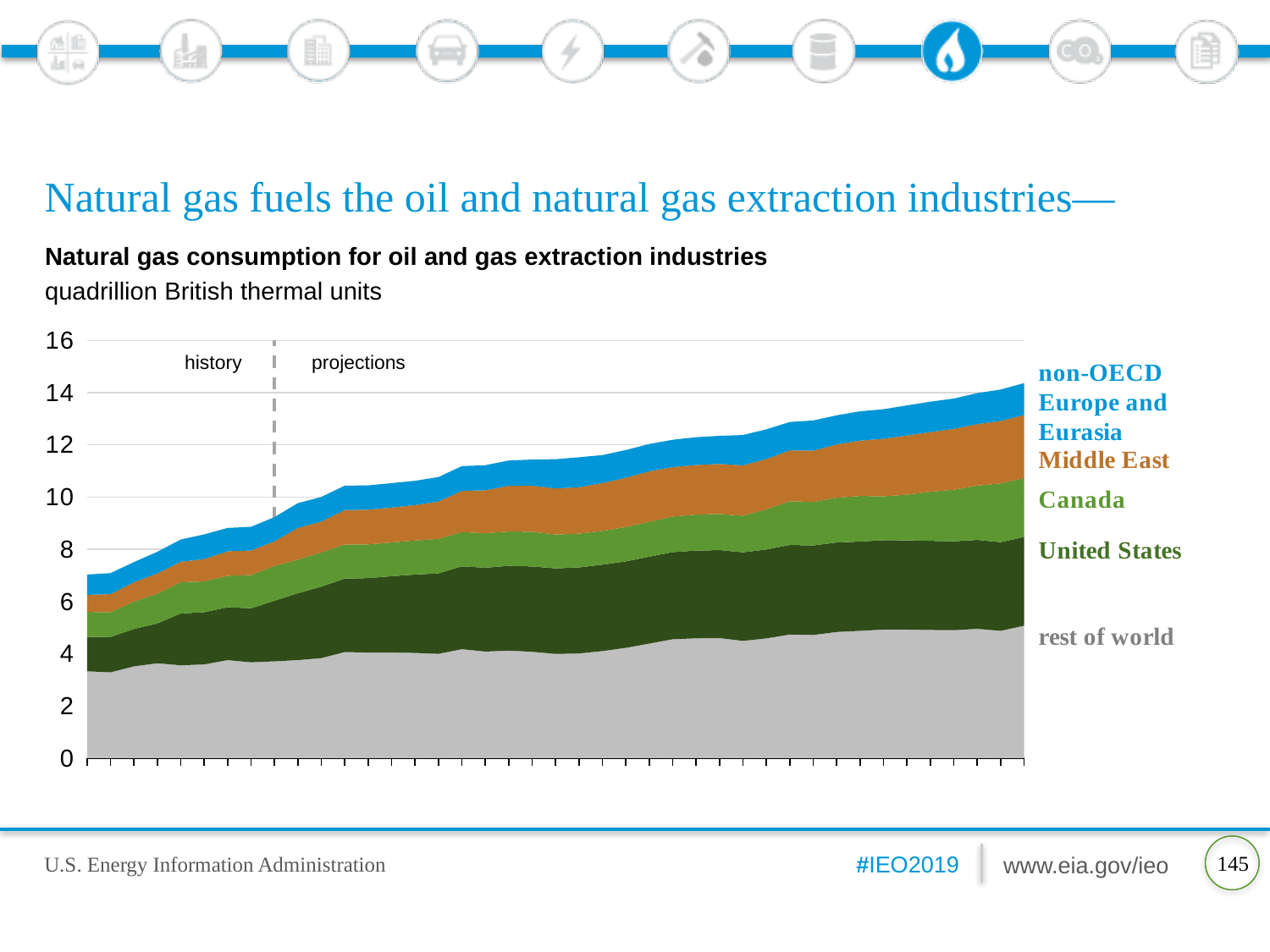
Is the total consumption at the start of the chart greater or less than 8? less What kind of chart is shown on the slide? stacked area chart Which is larger at the end of the projection period, the United States band or the Canada band? United States What is the highest value shown on the y axis? 16 Does total natural gas consumption for oil and gas extraction rise or fall over time along the x axis? rise Which series accounts for the largest share of consumption throughout the chart? rest of world Is the total consumption at the end of the projection period greater or less than 12? greater What unit is the chart's y axis measured in? quadrillion British thermal units Which series forms the bottom layer of the stacked area chart? rest of world How many series does the chart show? 5 Is the rest of world consumption at the end of the projection period greater or less than 4? greater